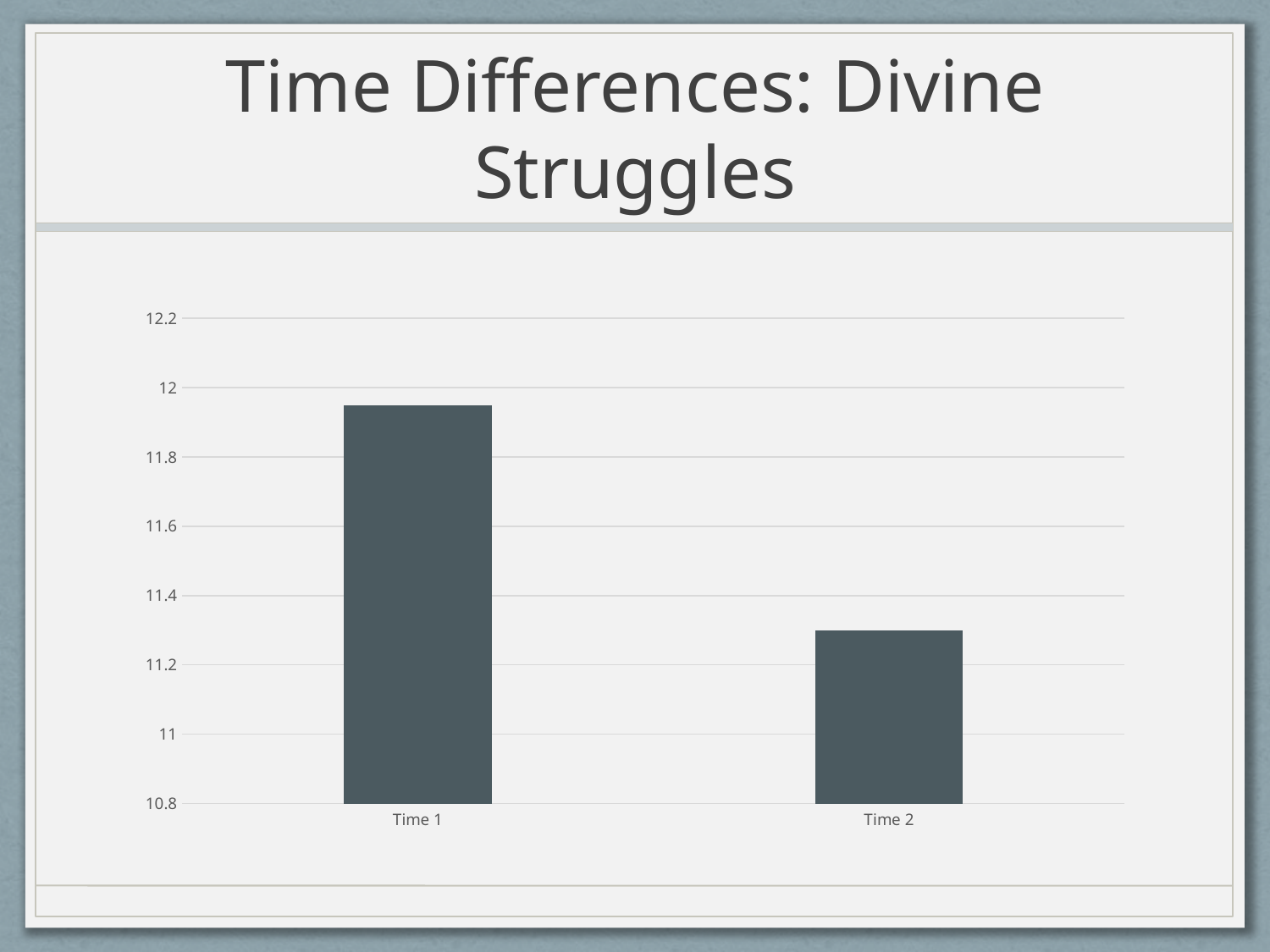
Is the value for Time 2 greater or less than 11.4? less Is the value for Time 1 greater or less than 11.8? greater Is the value for Time 2 greater or less than 11.2? greater Do the values rise or fall from Time 1 to Time 2? Fall How many categories are plotted in the chart? 2 Which category has the lowest value? Time 2 Which category has the highest value? Time 1 What is the title of the slide containing the chart? Time Differences: Divine Struggles What kind of chart is shown on the slide? Bar chart Which is larger, the value for Time 1 or the value for Time 2? Time 1 What is the lowest value shown on the vertical axis? 10.8